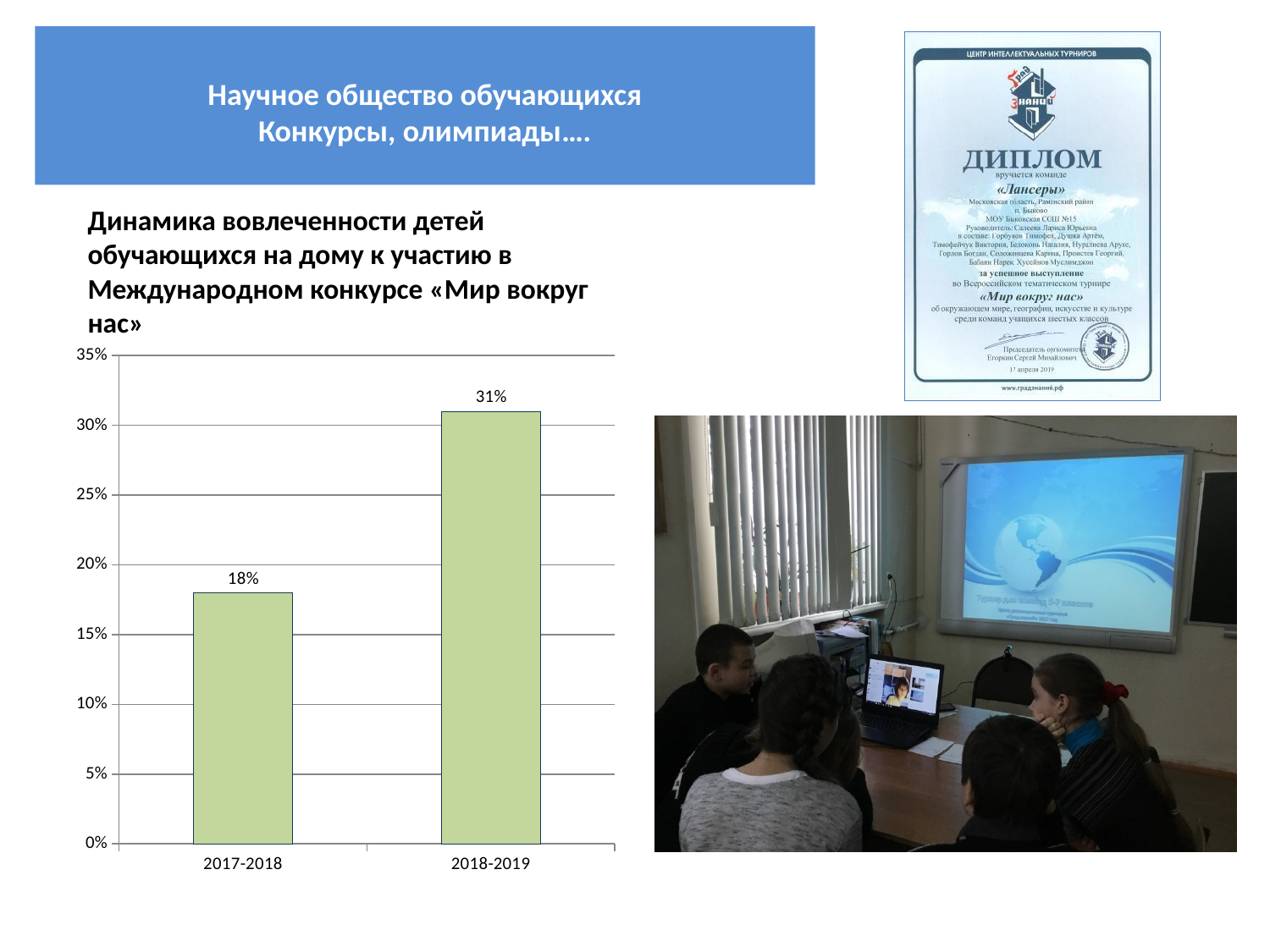
How many categories are shown on the x axis? 2 What is the value for 2018-2019? 31% What is the difference between the values for 2018-2019 and 2017-2018? 13% Is the value for 2017-2018 greater or less than 20%? less Which is larger, the value for 2017-2018 or the value for 2018-2019? 2018-2019 Do the values rise or fall from 2017-2018 to 2018-2019? rise What is the value for 2017-2018? 18% Which category has the lowest value? 2017-2018 What kind of chart is shown on the slide? bar chart What is the highest value shown on the y axis? 35% Is the value for 2018-2019 greater or less than 25%? greater Which category has the highest value? 2018-2019